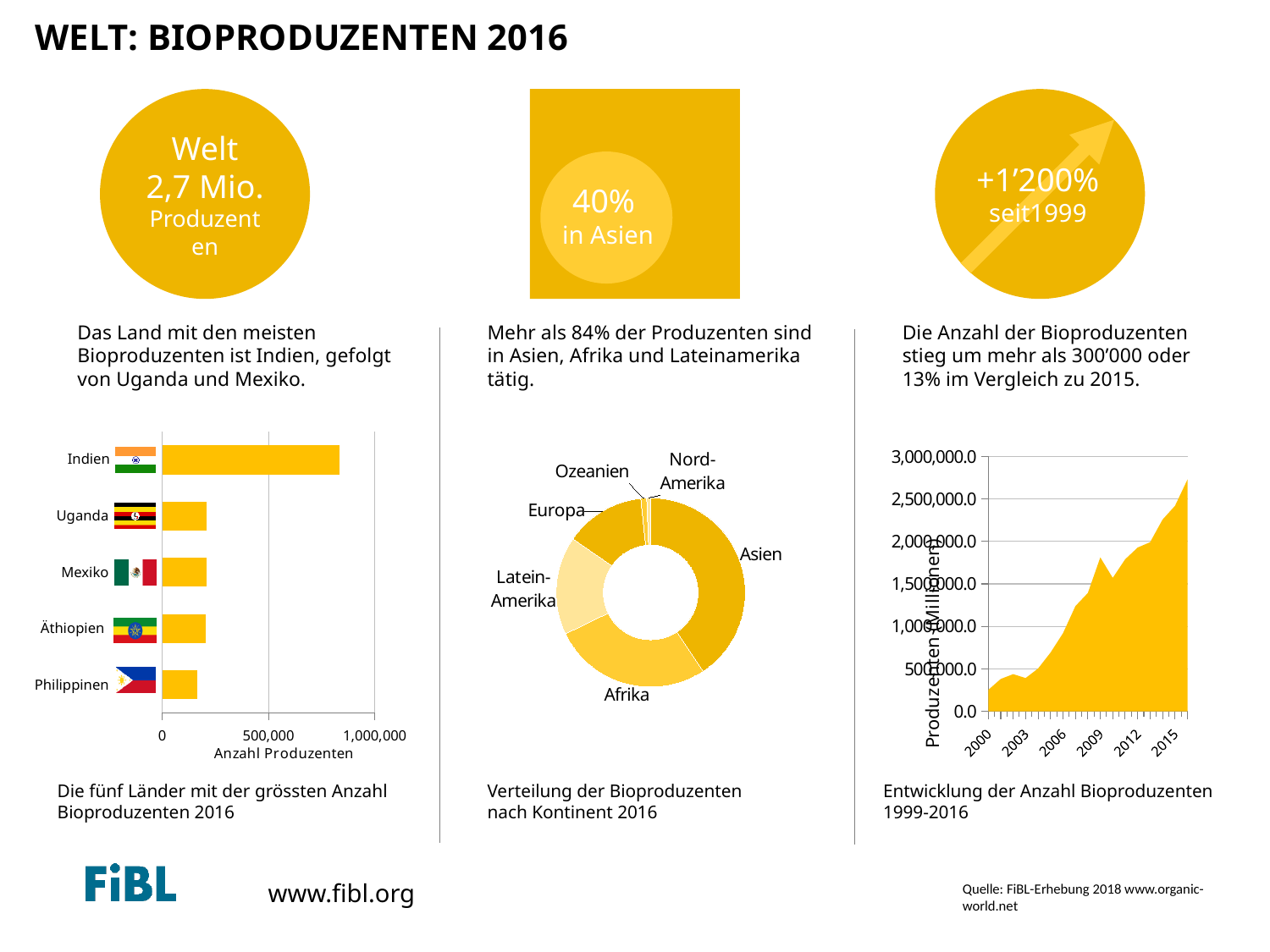
In the chart 'Entwicklung der Anzahl Bioproduzenten 1999-2016', do the values generally rise or fall over time? rise What kind of chart is 'Verteilung der Bioproduzenten nach Kontinent 2016'? Donut (pie) chart In the bar chart 'Die fünf Länder mit der grössten Anzahl Bioproduzenten 2016', which country has the lowest number of producers? Philippinen In the bar chart 'Die fünf Länder mit der grössten Anzahl Bioproduzenten 2016', is the value for Uganda greater or less than 500,000? less How many countries are shown in the bar chart 'Die fünf Länder mit der grössten Anzahl Bioproduzenten 2016'? 5 In the bar chart 'Die fünf Länder mit der grössten Anzahl Bioproduzenten 2016', is the value for Indien greater or less than 500,000? greater How many continents are shown in the chart 'Verteilung der Bioproduzenten nach Kontinent 2016'? 6 What is the x-axis title of the bar chart 'Die fünf Länder mit der grössten Anzahl Bioproduzenten 2016'? Anzahl Produzenten In the chart 'Verteilung der Bioproduzenten nach Kontinent 2016', which continent has the largest share? Asien In the bar chart 'Die fünf Länder mit der grössten Anzahl Bioproduzenten 2016', which country has the highest number of producers? Indien In the bar chart 'Die fünf Länder mit der grössten Anzahl Bioproduzenten 2016', which is larger, the value for Indien or the value for Mexiko? Indien In the chart 'Entwicklung der Anzahl Bioproduzenten 1999-2016', is the value for 2015 greater or less than 2,000,000.0? greater